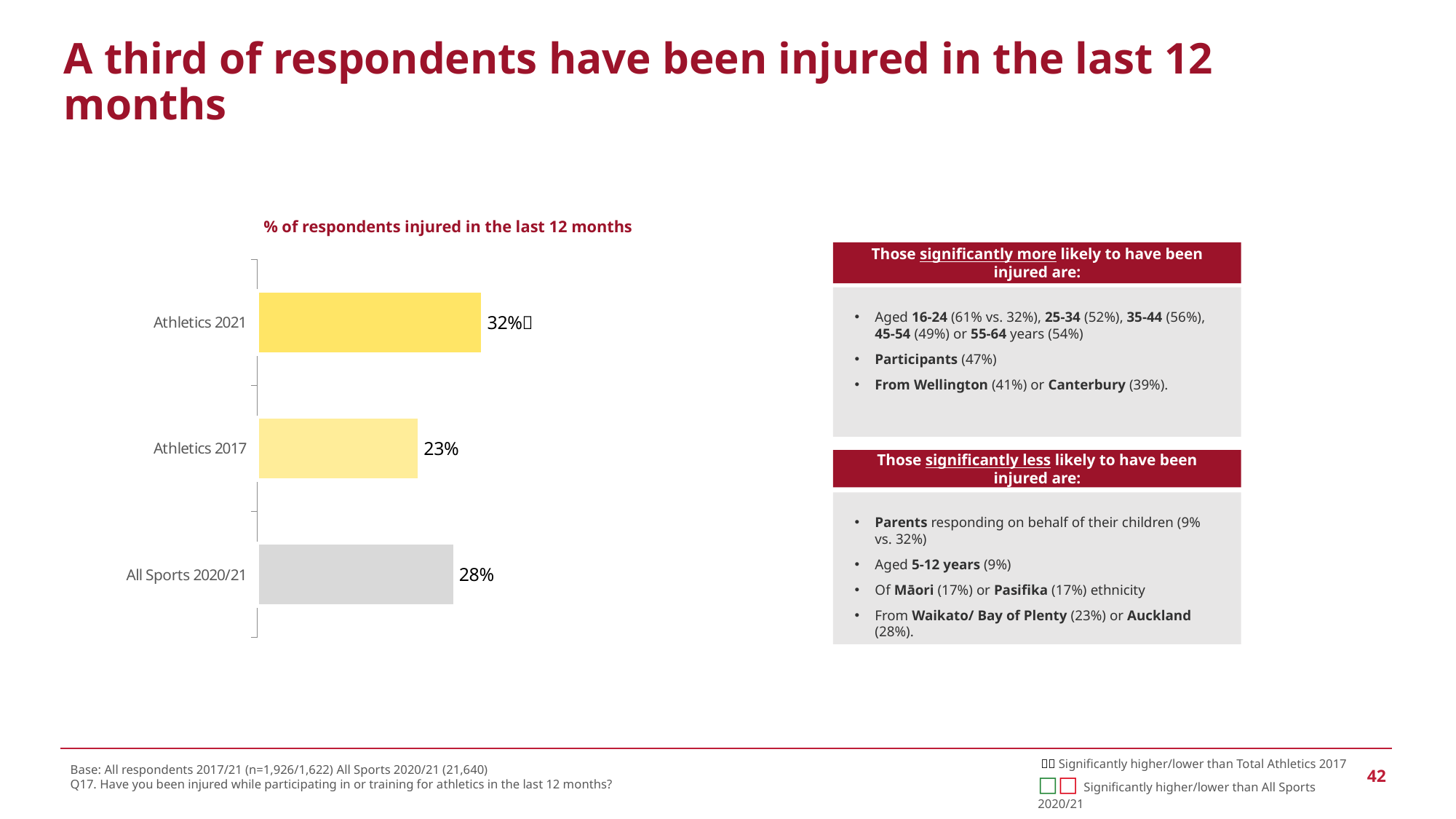
Which category has the highest percentage of respondents injured? Athletics 2021 How many categories are shown in the chart? 3 What is the difference between the Athletics 2021 and All Sports 2020/21 values? 4 percentage points What is the value for Athletics 2017? 23% What kind of chart is shown on the slide? Bar chart Which category has the lowest percentage of respondents injured? Athletics 2017 What is the value for Athletics 2021? 32% What is the value for All Sports 2020/21? 28% What is the difference between the Athletics 2021 and Athletics 2017 values? 9 percentage points What colour is the All Sports 2020/21 bar? Grey Which is larger, the value for Athletics 2017 or All Sports 2020/21? All Sports 2020/21 What is the title of the chart? % of respondents injured in the last 12 months